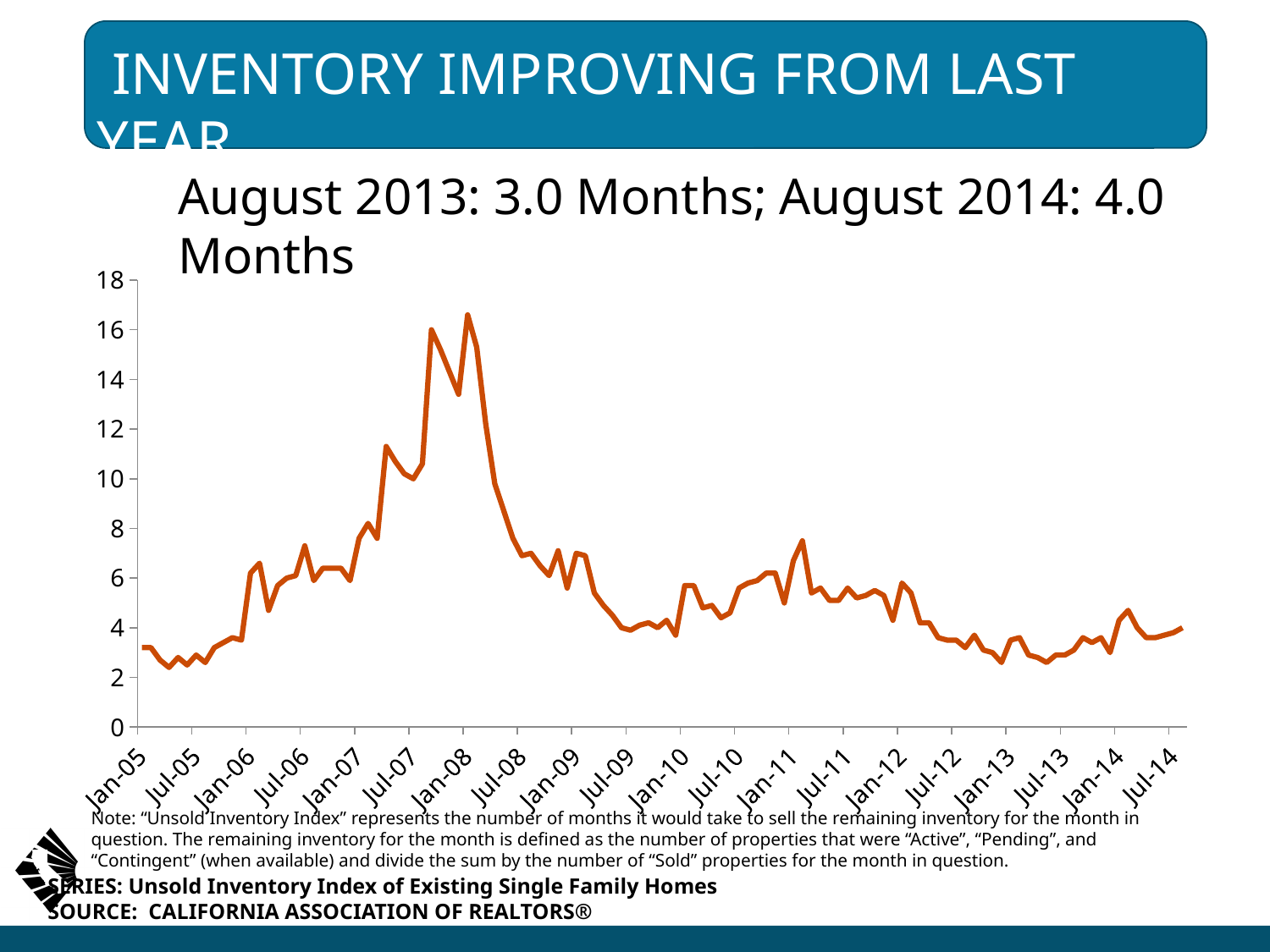
According to the slide, what was the Unsold Inventory Index in August 2013? 3.0 Months Is the value of the line around Jan-11 greater or less than 6? greater What is the highest value shown on the vertical axis? 18 In which year does the line reach its highest value? 2008 Is the value of the line around Jan-08 greater or less than 14? greater Is the value of the line at Jan-05 greater or less than 4? less What kind of chart is shown on the slide? line chart Does the line rise or fall between Jan-08 and Jan-10? fall Which is larger, the Unsold Inventory Index for August 2013 or for August 2014? August 2014 What series does the chart plot, according to the text below it? Unsold Inventory Index of Existing Single Family Homes By how many months did the Unsold Inventory Index change from August 2013 to August 2014? 1.0 Months According to the slide, what was the Unsold Inventory Index in August 2014? 4.0 Months